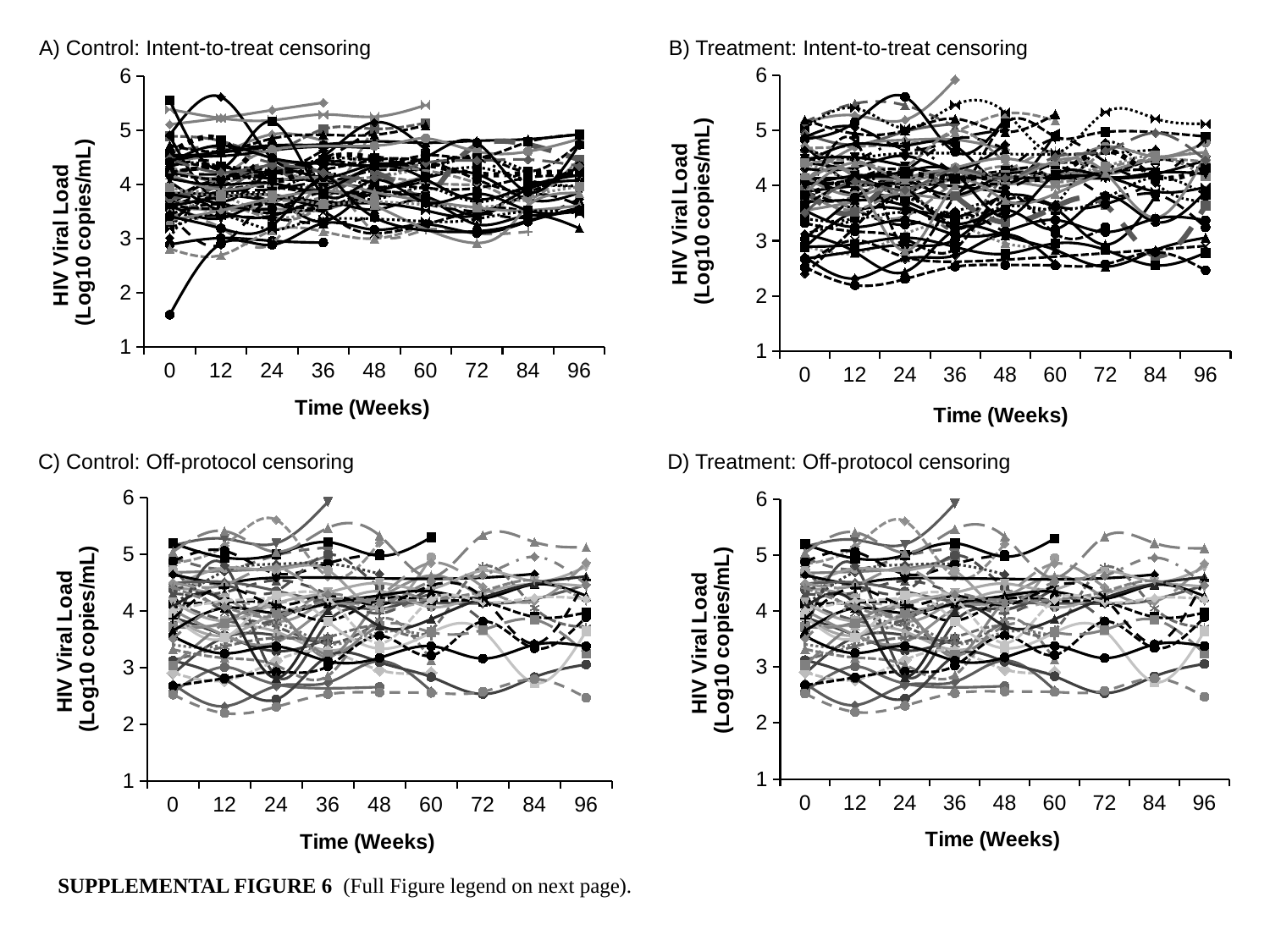
In panel D (Treatment: Off-protocol censoring), is the highest plotted value at week 36 greater or less than 5? greater What kind of chart is panel A (Control: Intent-to-treat censoring)? line chart In panel B (Treatment: Intent-to-treat censoring), how many time points are labelled on the x axis? 9 In panel A (Control: Intent-to-treat censoring), what is the lowest value labelled on the y axis? 1 In panel B (Treatment: Intent-to-treat censoring), is the lowest plotted value at week 12 greater or less than 3? less In panel C (Control: Off-protocol censoring), what is the highest value labelled on the y axis? 6 What is the x-axis title of panel A (Control: Intent-to-treat censoring)? Time (Weeks) What is the y-axis title of panel D (Treatment: Off-protocol censoring)? HIV Viral Load (Log10 copies/mL) What kind of chart is panel D (Treatment: Off-protocol censoring)? line chart In panel C (Control: Off-protocol censoring), how many time points are labelled on the x axis? 9 In panel A (Control: Intent-to-treat censoring), is the lowest plotted value at week 0 greater or less than 2? less In panel B (Treatment: Intent-to-treat censoring), what is the last time point labelled on the x axis? 96